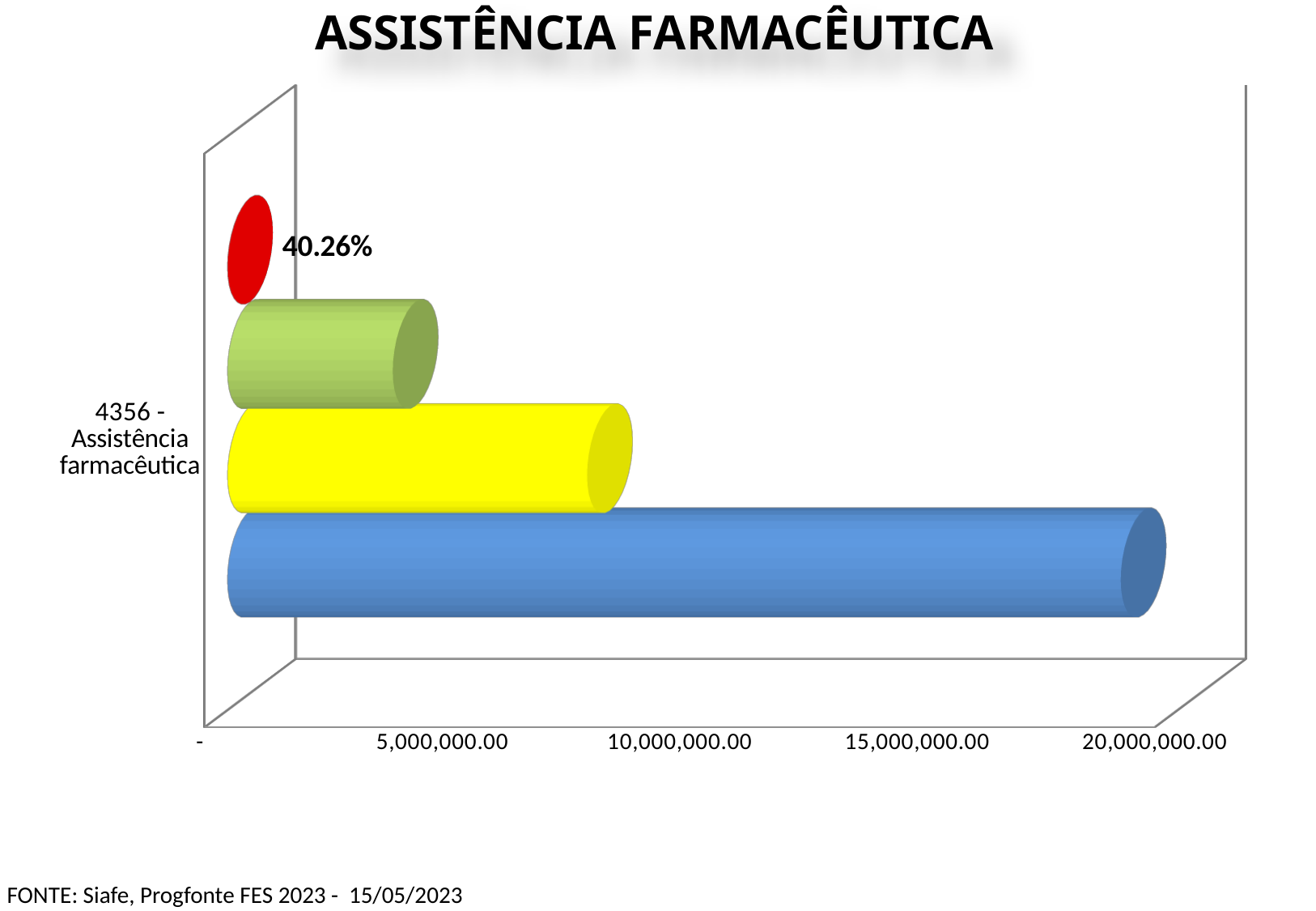
Is the value of the yellow bar greater or less than 5,000,000.00? greater What is the title of the chart? ASSISTÊNCIA FARMACÊUTICA What is the highest value shown on the horizontal axis? 20,000,000.00 What percentage value is printed as a data label on the chart? 40.26% Which is larger, the blue bar or the yellow bar? blue bar What is the name of the category shown on the chart? 4356 - Assistência farmacêutica Is the value of the green bar greater or less than 5,000,000.00? less Is the value of the blue bar greater or less than 15,000,000.00? greater What kind of chart is shown on the slide? bar chart How many categories are shown on the chart's category axis? 1 Which coloured bar is the shortest on the chart? red Which coloured bar is the longest on the chart? blue